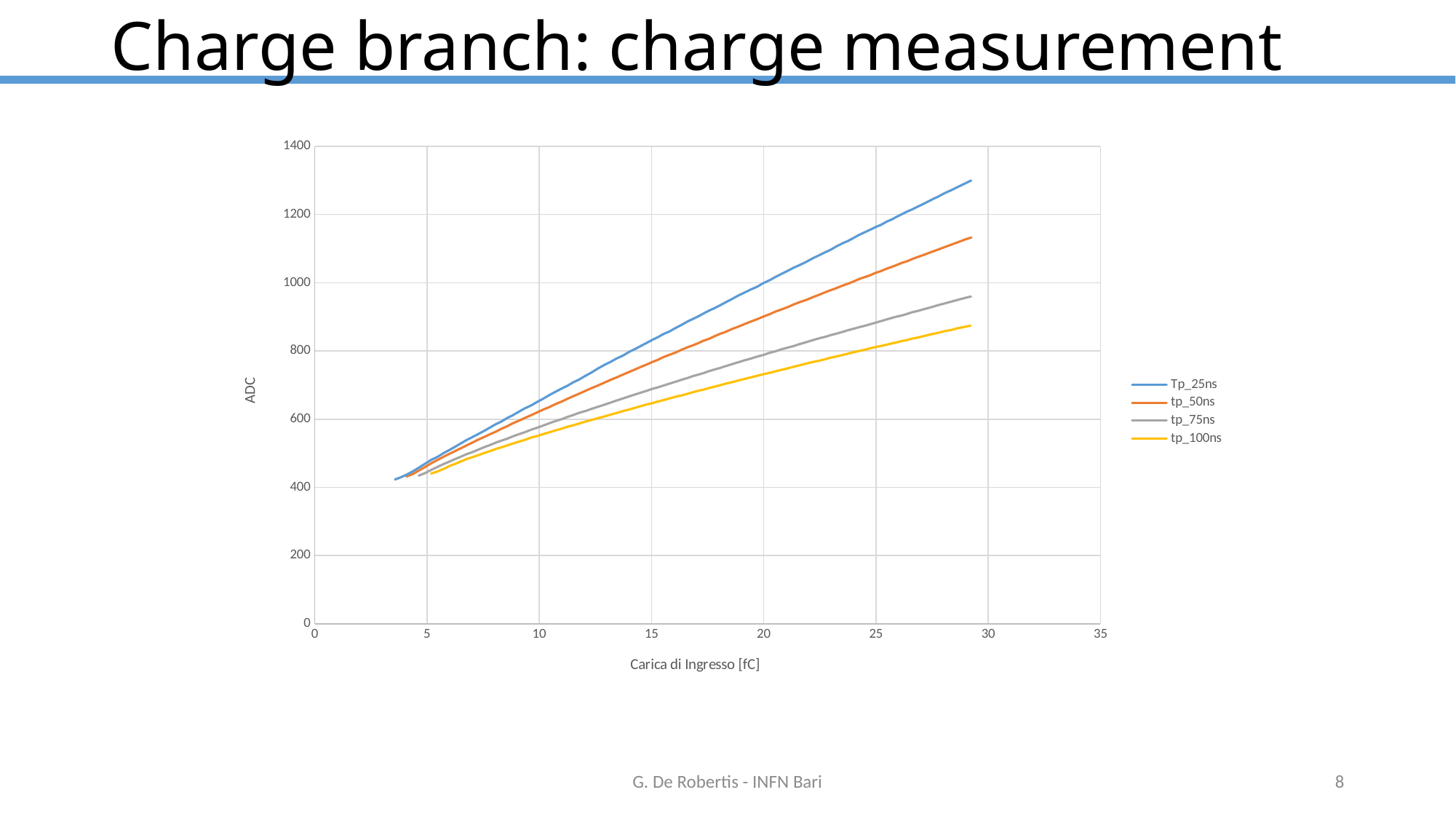
Which series reaches the highest ADC value at the right end of the chart? Tp_25ns What is the label of the y axis? ADC At the right end of the chart, is the ADC value for tp_100ns greater or less than 1000? less Which series has the lowest ADC value at the right end of the chart? tp_100ns What kind of chart is shown on the slide? line chart Do the ADC values rise or fall as the input charge increases along the x axis? rise At the right end of the chart, is the ADC value for tp_50ns greater or less than 1000? greater What is the label of the x axis? Carica di Ingresso [fC] At the right end of the chart, is the ADC value for tp_75ns greater or less than 1000? less At an input charge of 25 fC, which series has the larger ADC value, tp_50ns or tp_75ns? tp_50ns How many series does the legend list? 4